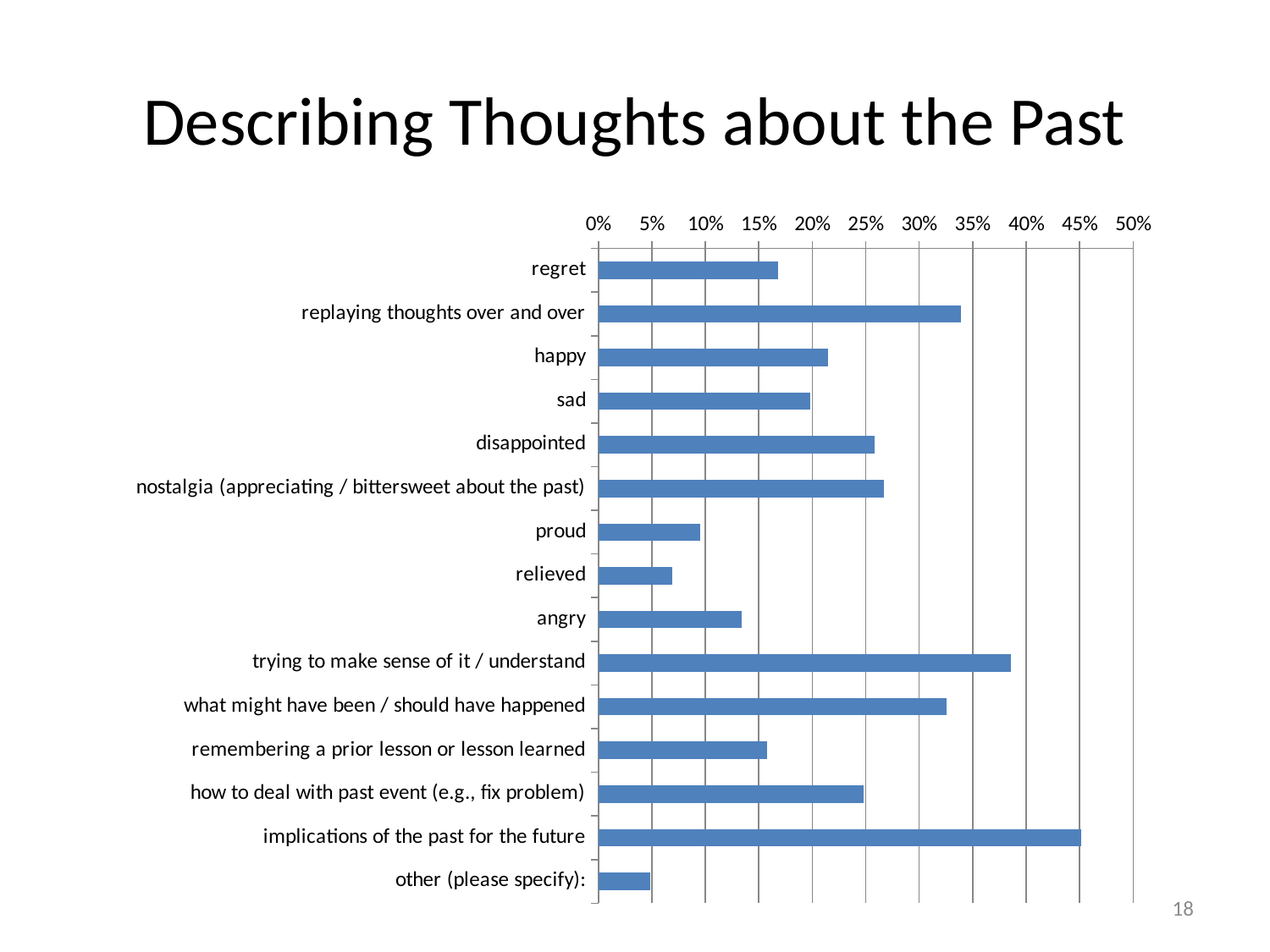
Is the value for 'angry' greater or less than 10%? greater Is the value for 'trying to make sense of it / understand' greater or less than 35%? greater Is the value for 'replaying thoughts over and over' greater or less than 30%? greater Which category has the lowest value? other (please specify): What is the title of the slide containing the chart? Describing Thoughts about the Past What type of chart is shown on the slide? bar chart Which category has the highest value? implications of the past for the future How many categories are plotted in the chart? 15 Which is larger: the value for 'trying to make sense of it / understand' or for 'replaying thoughts over and over'? trying to make sense of it / understand Which is larger: the value for 'regret' or for 'angry'? regret